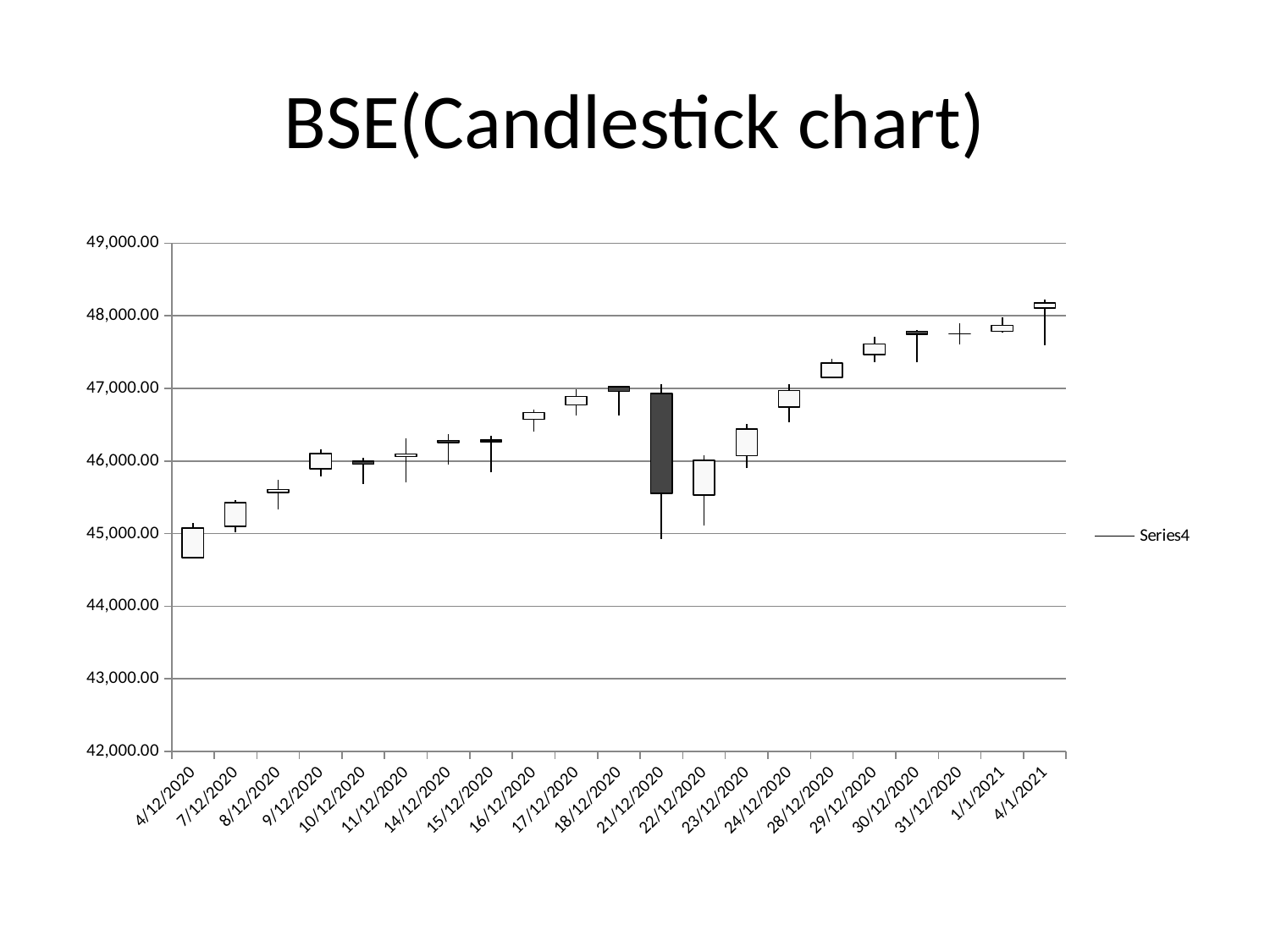
What kind of chart is shown on the slide? Candlestick chart How many dates are plotted along the x axis? 21 Which date has the lowest candle on the chart? 4/12/2020 Do the values generally rise or fall from 4/12/2020 to 4/1/2021? Rise What is the title of the chart? BSE(Candlestick chart) Is the value for 4/1/2021 greater or less than 47,000.00? greater Is the value for 18/12/2020 greater or less than 46,000.00? greater How many series does the legend list? 1 What is the name of the series shown in the legend? Series4 Is the value for 22/12/2020 greater or less than 47,000.00? less Which date has the highest candle on the chart? 4/1/2021